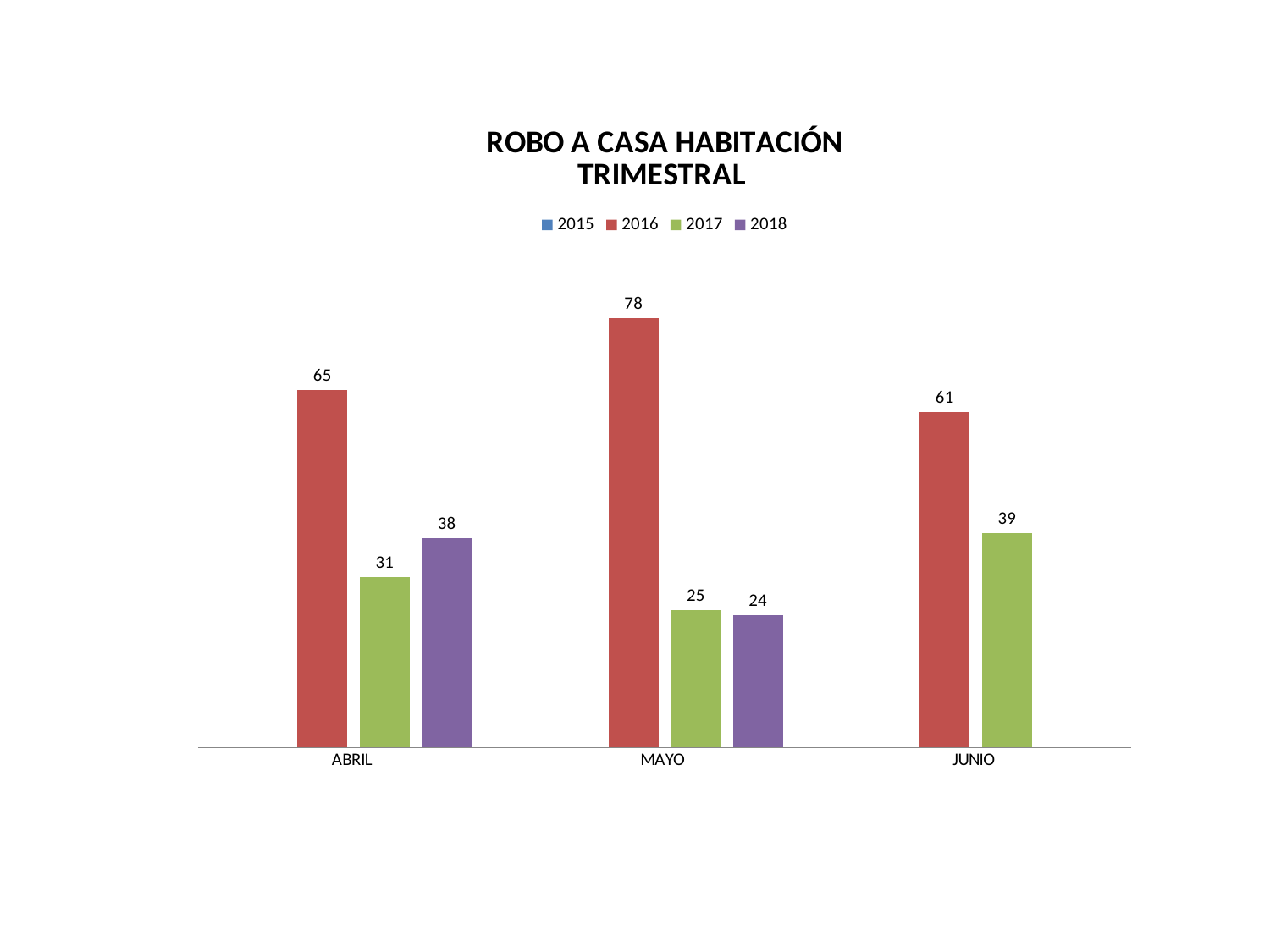
In which month is the 2017 value lowest? MAYO How many months are shown on the x axis? 3 What kind of chart is shown on the slide? Bar chart What is the difference between the 2016 and 2017 values in ABRIL? 34 What is the value for 2016 in JUNIO? 61 In which month is the 2016 value highest? MAYO What is the title of the chart? ROBO A CASA HABITACIÓN TRIMESTRAL What is the value for 2018 in MAYO? 24 How many series does the legend list? 4 What is the value for 2016 in MAYO? 78 Which is larger in ABRIL, the 2017 value or the 2018 value? 2018 What is the value for 2017 in ABRIL? 31